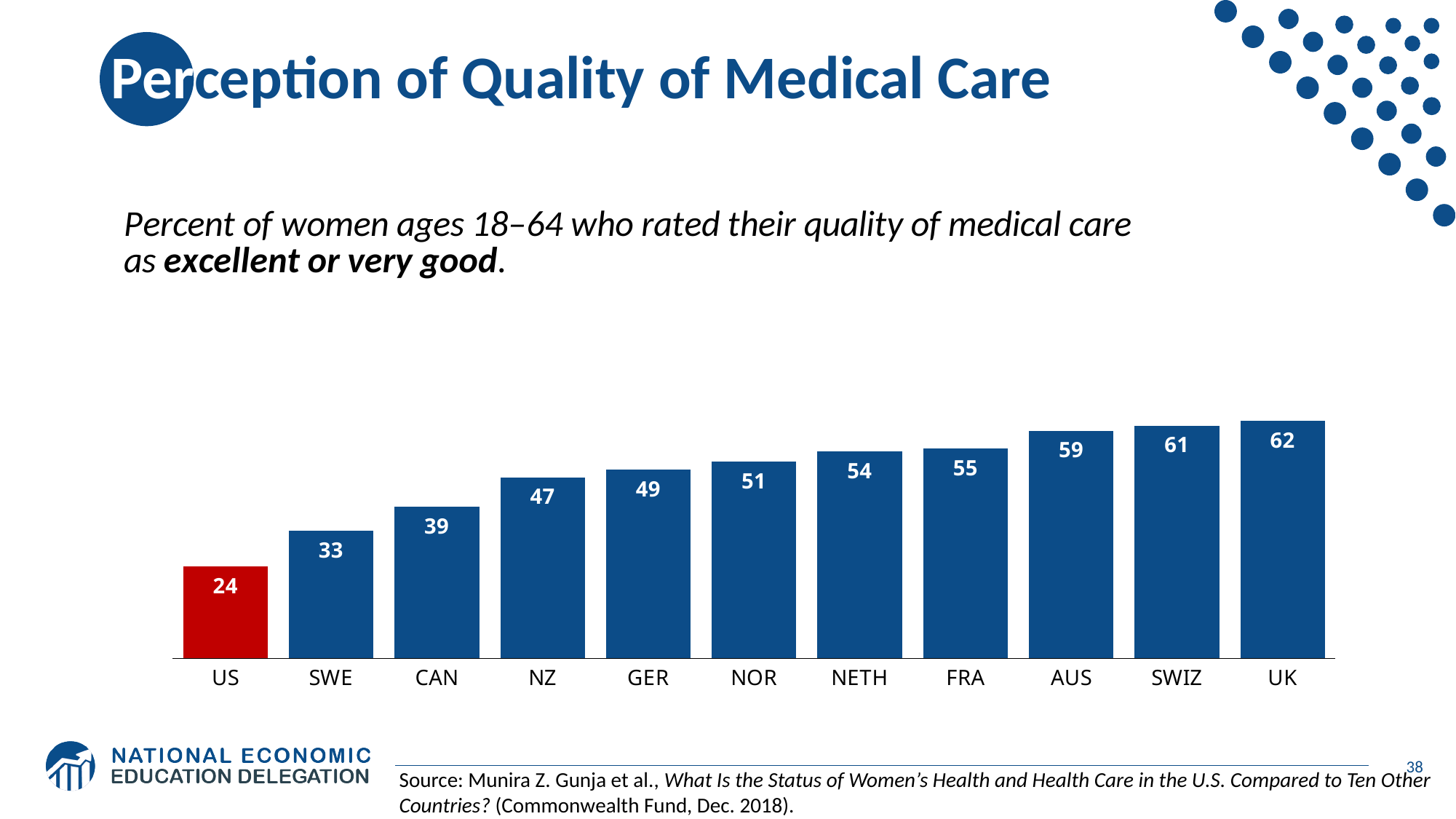
Which country has the highest value? UK Which has a larger value, NOR or NZ? NOR Which bar is coloured red rather than blue? US What is the difference between the values for UK and US? 38 How many countries are shown in the chart? 11 What is the value for AUS? 59 Do the values rise or fall from left to right along the x axis? rise Which country has the lowest value? US What is the value for GER? 49 What kind of chart is shown on the slide? bar chart What is the difference between the values for CAN and SWE? 6 What is the value for the US? 24